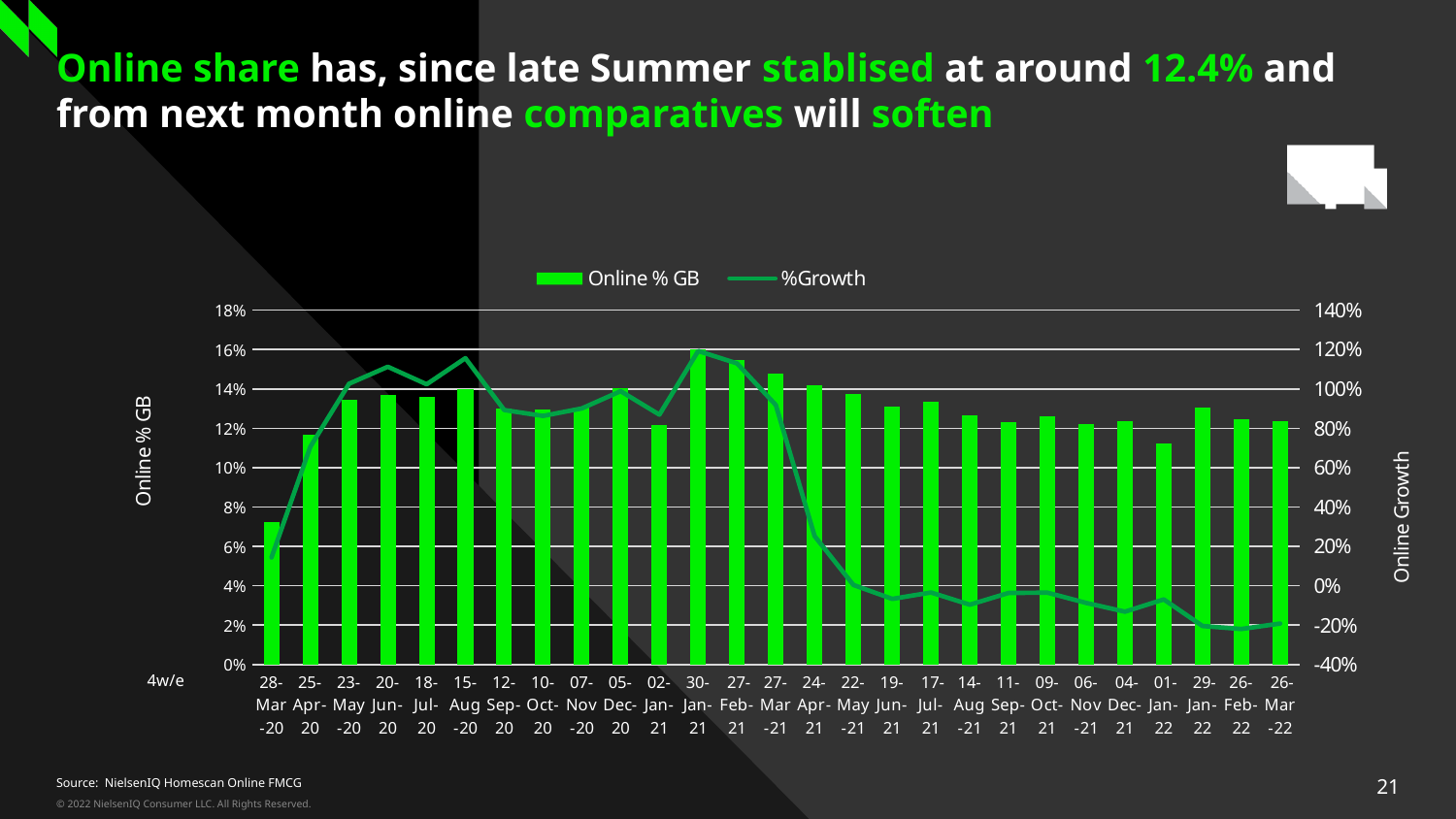
How many series does the legend list? 2 Which period has the lowest Online % GB bar? 28-Mar-20 Is the %Growth value for 26-Feb-22 greater or less than 0%? less Is the Online % GB value for 28-Mar-20 greater or less than 8%? less Is the Online % GB value for 30-Jan-21 greater or less than 14%? greater What are the two series named in the legend? Online % GB and %Growth Which has the larger Online % GB bar, 01-Jan-22 or 29-Jan-22? 29-Jan-22 How many 4w/e periods are plotted along the x axis? 27 Does the %Growth line rise or fall between 27-Feb-21 and 24-Apr-21? Fall Which period has the highest Online % GB bar? 30-Jan-21 What kind of chart is shown on the slide? Combination bar and line chart